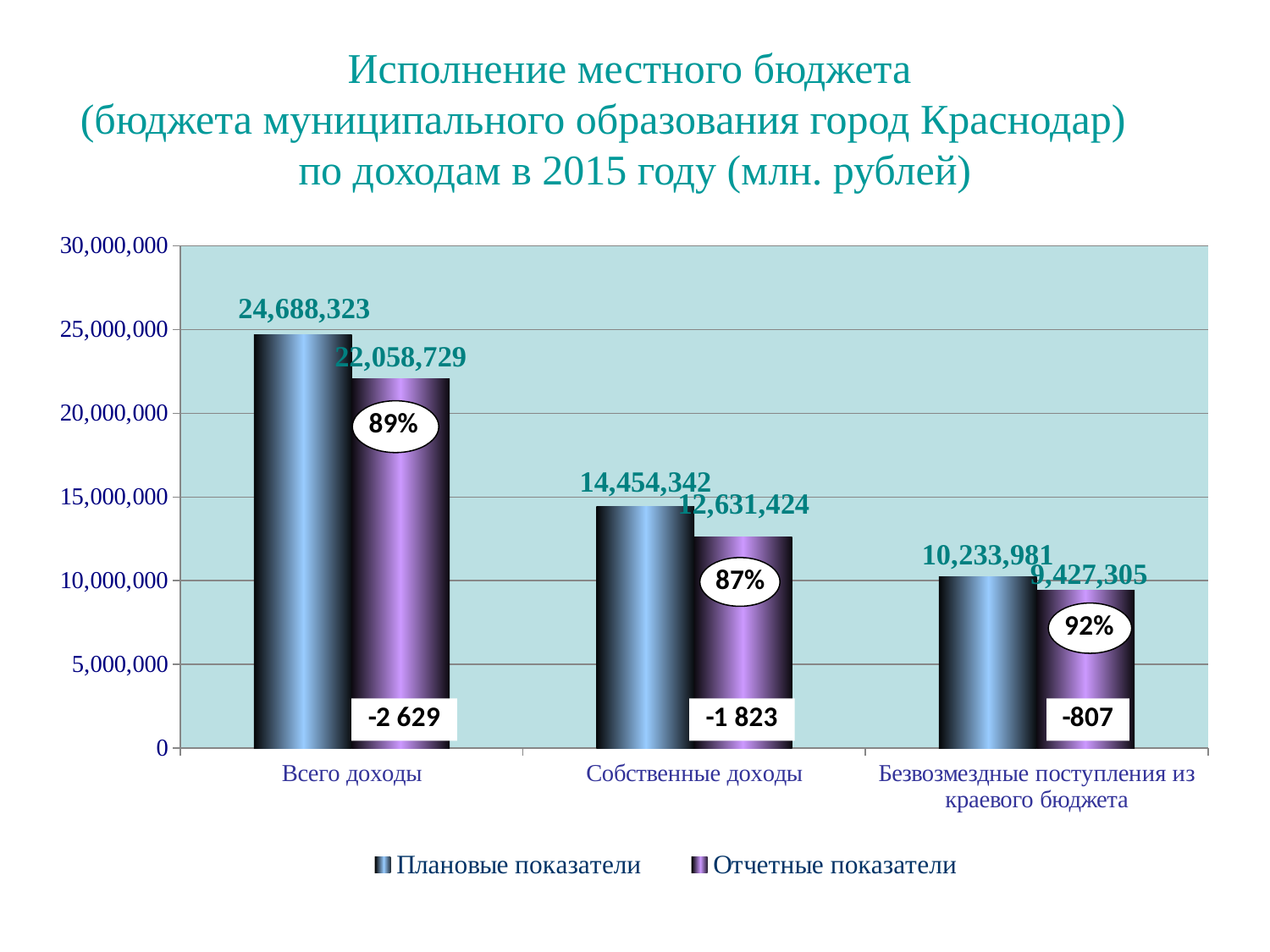
What is the difference between Плановые показатели and Отчетные показатели for Собственные доходы? 1,822,918 How many categories are shown on the x axis? 3 Which category has the lowest value for Плановые показатели? Безвозмездные поступления из краевого бюджета What percentage is shown in the oval on the Отчетные показатели bar for Собственные доходы? 87% What is the value of Отчетные показатели for Всего доходы? 22,058,729 Which category has the highest value for Отчетные показатели? Всего доходы What kind of chart is shown on the slide? Bar chart Which is larger for Безвозмездные поступления из краевого бюджета: Плановые показатели or Отчетные показатели? Плановые показатели What is the value of Плановые показатели for Всего доходы? 24,688,323 What is the value of Плановые показатели for Собственные доходы? 14,454,342 What is the value of Отчетные показатели for Безвозмездные поступления из краевого бюджета? 9,427,305 How many series does the legend list? 2